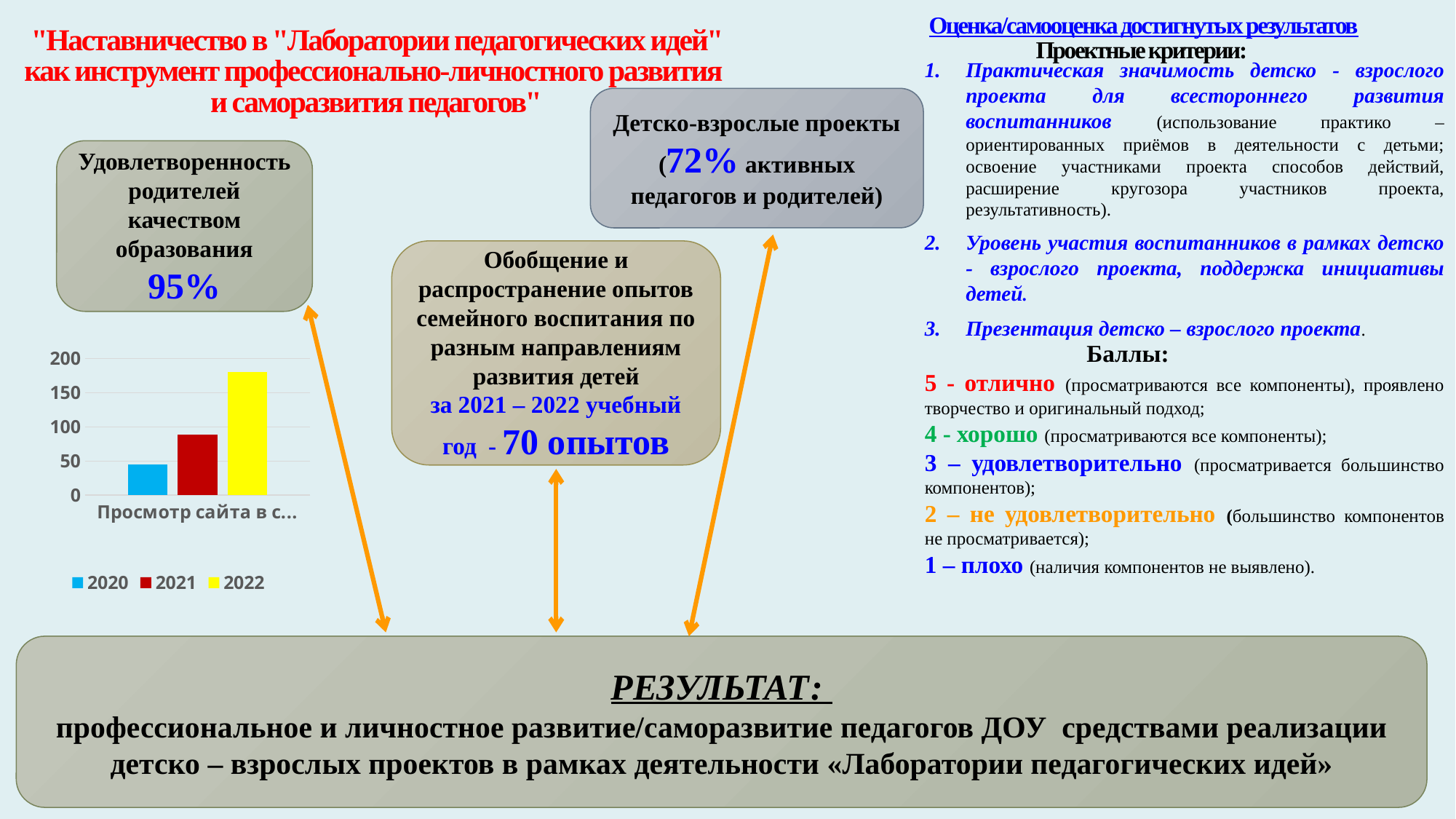
In the bar chart, is the bar for 2020 larger or smaller than the bar for 2021? smaller How many categories are shown on the x axis of the bar chart? 1 Is the value for 2022 in the bar chart greater or less than 150? greater In the bar chart, is the bar for 2021 larger or smaller than the bar for 2022? smaller What is the highest value shown on the y axis of the bar chart? 200 What kind of chart is shown on the left of the slide? bar chart What colour is the bar for 2022 in the bar chart? yellow Which series has the highest bar in the bar chart? 2022 Is the value for 2021 in the bar chart greater or less than 100? less How many series does the legend of the bar chart list? 3 Which series has the lowest bar in the bar chart? 2020